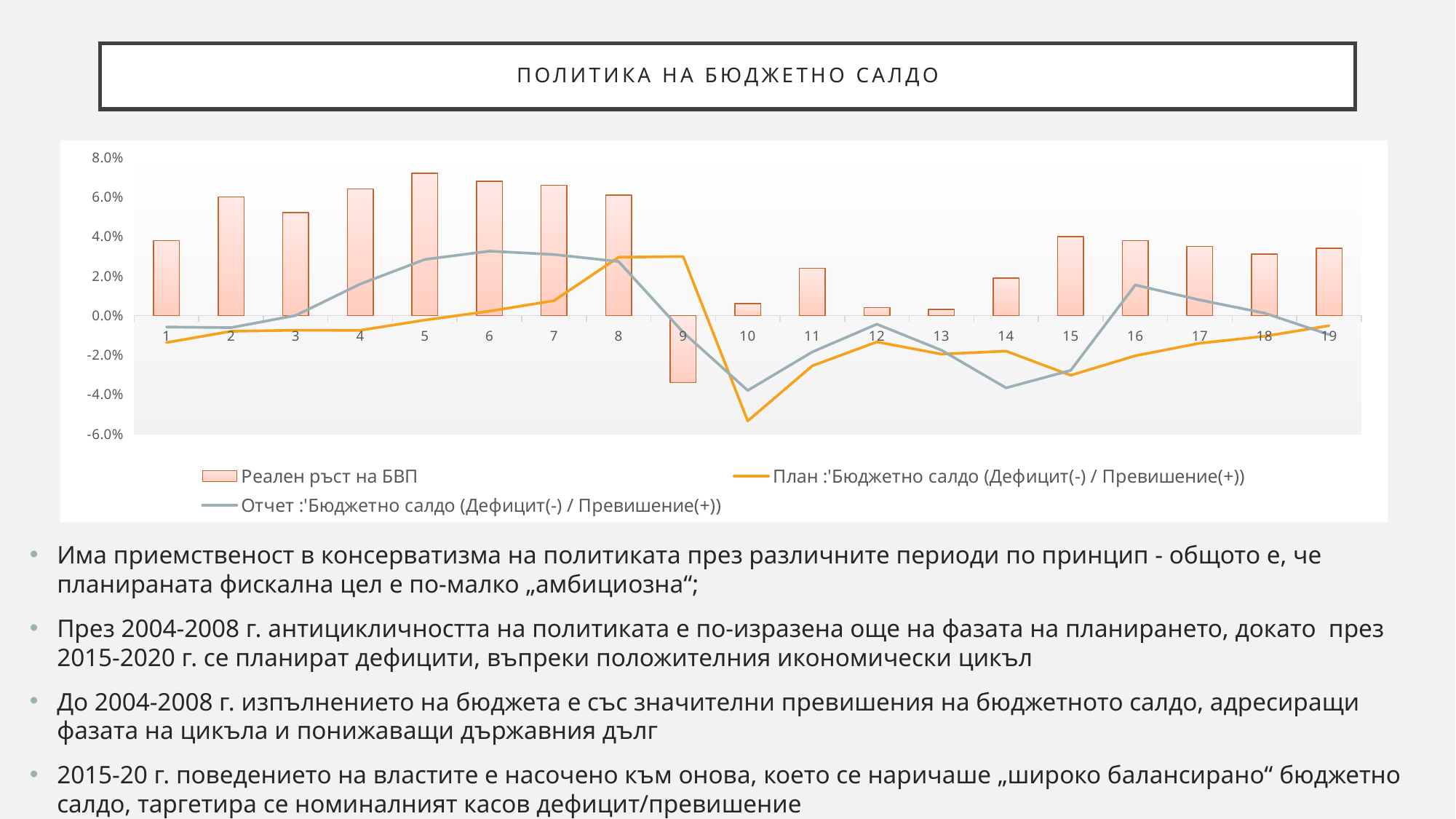
Do the Реален ръст на БВП bars rise or fall from category 5 to category 10? Fall What kind of chart is shown on the slide? A combined bar and line chart How many series does the chart legend list? 3 Is the Реален ръст на БВП bar for category 1 greater or less than 2.0%? greater What is the title of the slide above the chart? ПОЛИТИКА НА БЮДЖЕТНО САЛДО Is the Реален ръст на БВП bar for category 9 greater or less than -2.0%? less Is the Реален ръст на БВП bar for category 10 greater or less than 2.0%? less Which category has the lowest bar for Реален ръст на БВП? 9 Which is larger, the Реален ръст на БВП bar for category 2 or for category 13? Category 2 Which series is drawn as an orange line in the chart? План :'Бюджетно салдо (Дефицит(-) / Превишение(+)) How many categories are shown along the x axis of the chart? 19